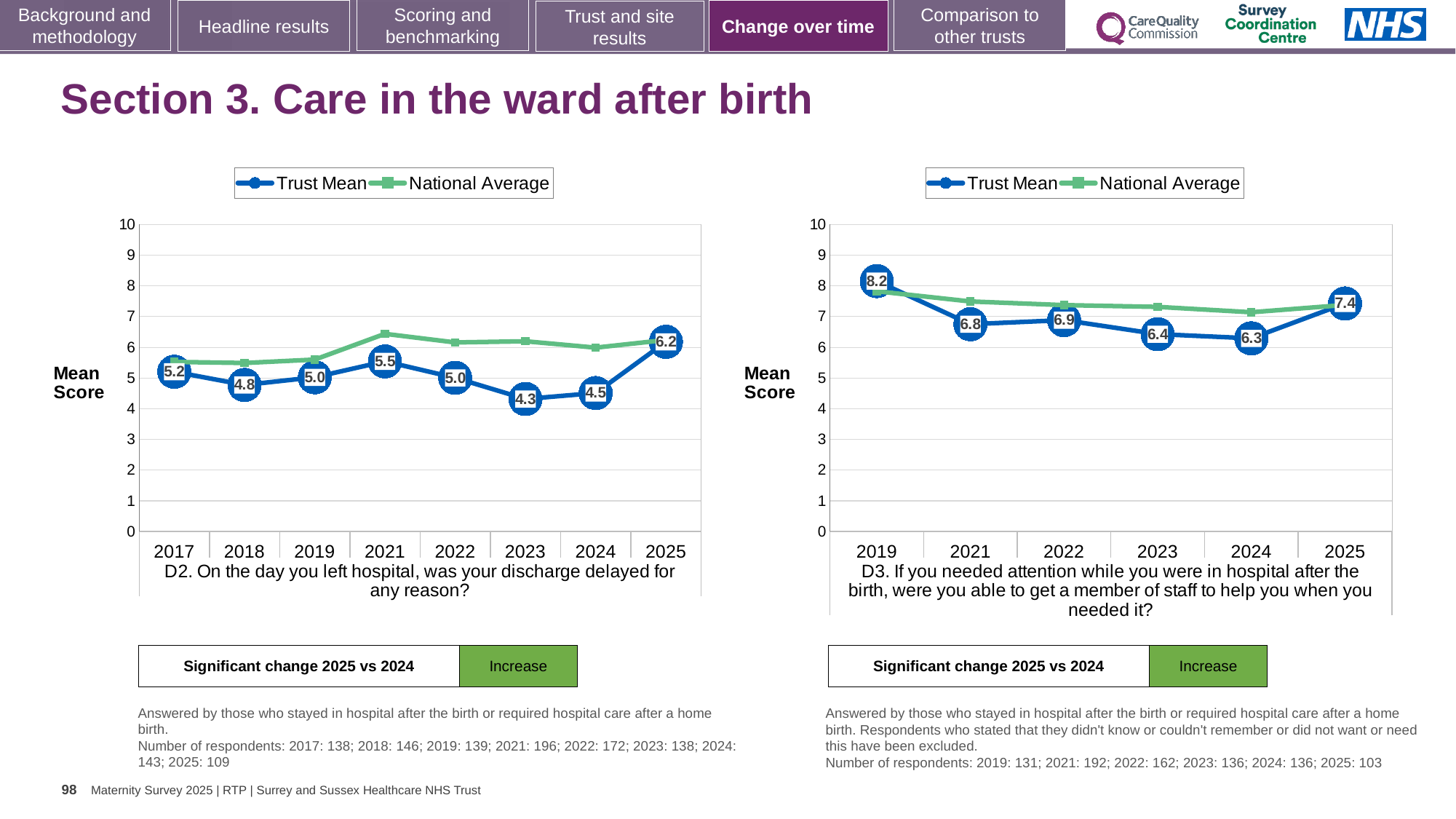
What type of chart is the D2 chart (left)? Line chart In the D2 chart (left), is the National Average for 2021 greater or less than 6? greater In the D3 chart (right), which is larger, the Trust Mean for 2022 or for 2024? 2022 In the D2 chart (left), what is the difference between the Trust Mean scores for 2025 and 2024? 1.7 In the D3 chart (right), what is the difference between the Trust Mean scores for 2019 and 2024? 1.9 In the D2 chart (left), what is the Trust Mean score for 2025? 6.2 How many series does the legend of the D3 chart (right) list? 2 In the D2 chart (left), what is the Trust Mean score for 2023? 4.3 In the D3 chart (right), what is the Trust Mean score for 2019? 8.2 In the D3 chart (right), which year has the highest Trust Mean score? 2019 In the D2 chart (left), how many years are shown on the x axis? 8 In the D2 chart (left), which year has the lowest Trust Mean score? 2023